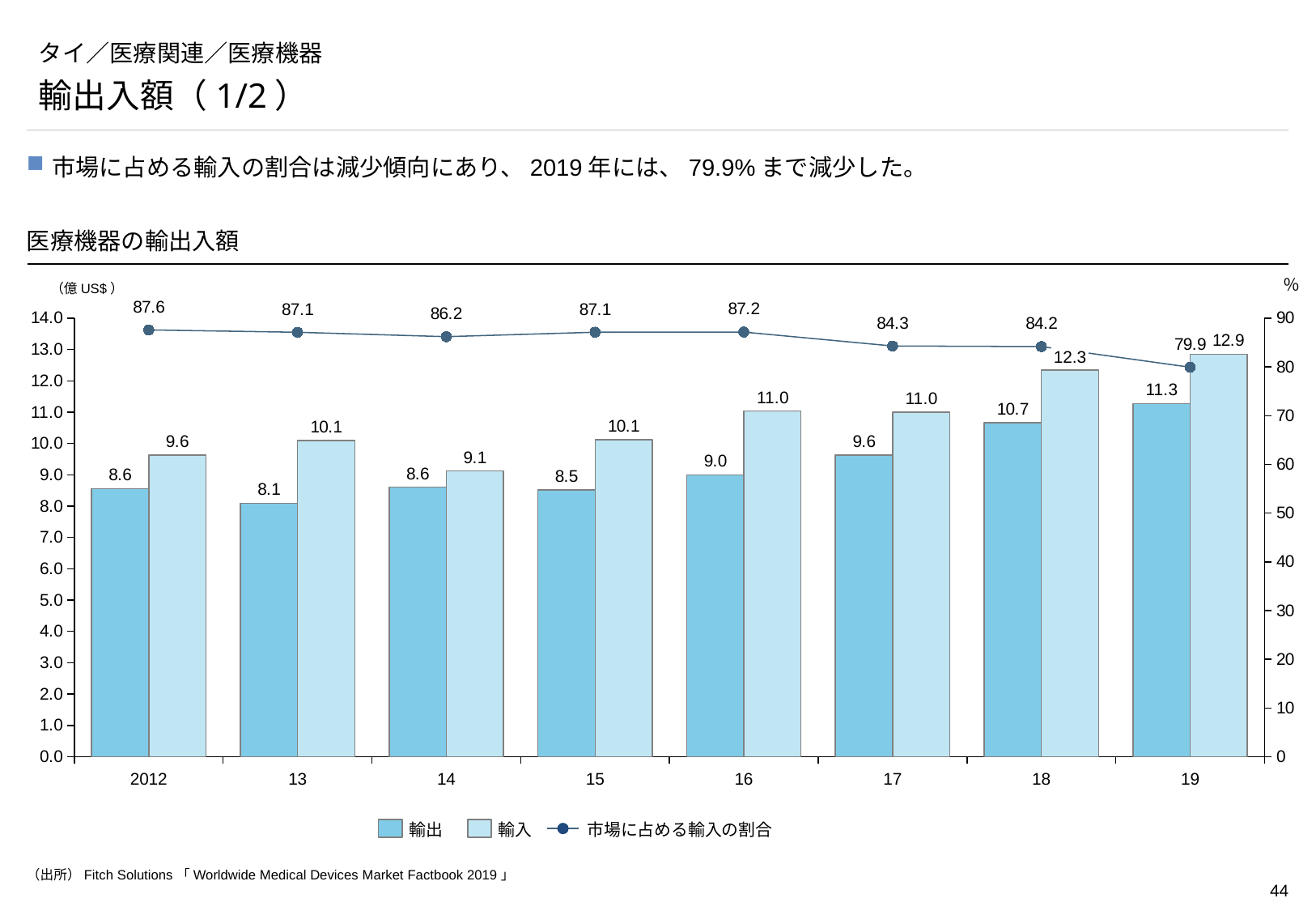
How many series does the legend list? 3 What is the 輸出 (export) value for 2012? 8.6 What is the 市場に占める輸入の割合 value for 14? 86.2 Which year has the highest 輸入 (import) value? 19 What is the unit shown for the left axis? 億 US$ What kind of chart is this? Combined bar and line chart Which is larger, the 輸出 value for 17 or the 輸出 value for 16? 17 How many years are shown on the x axis? 8 Which year has the lowest 輸出 (export) value? 13 Does the 市場に占める輸入の割合 line rise or fall from 2012 to 19? Fall What is the 輸入 (import) value for 19? 12.9 What is the difference between the 輸入 and 輸出 values for 18? 1.6